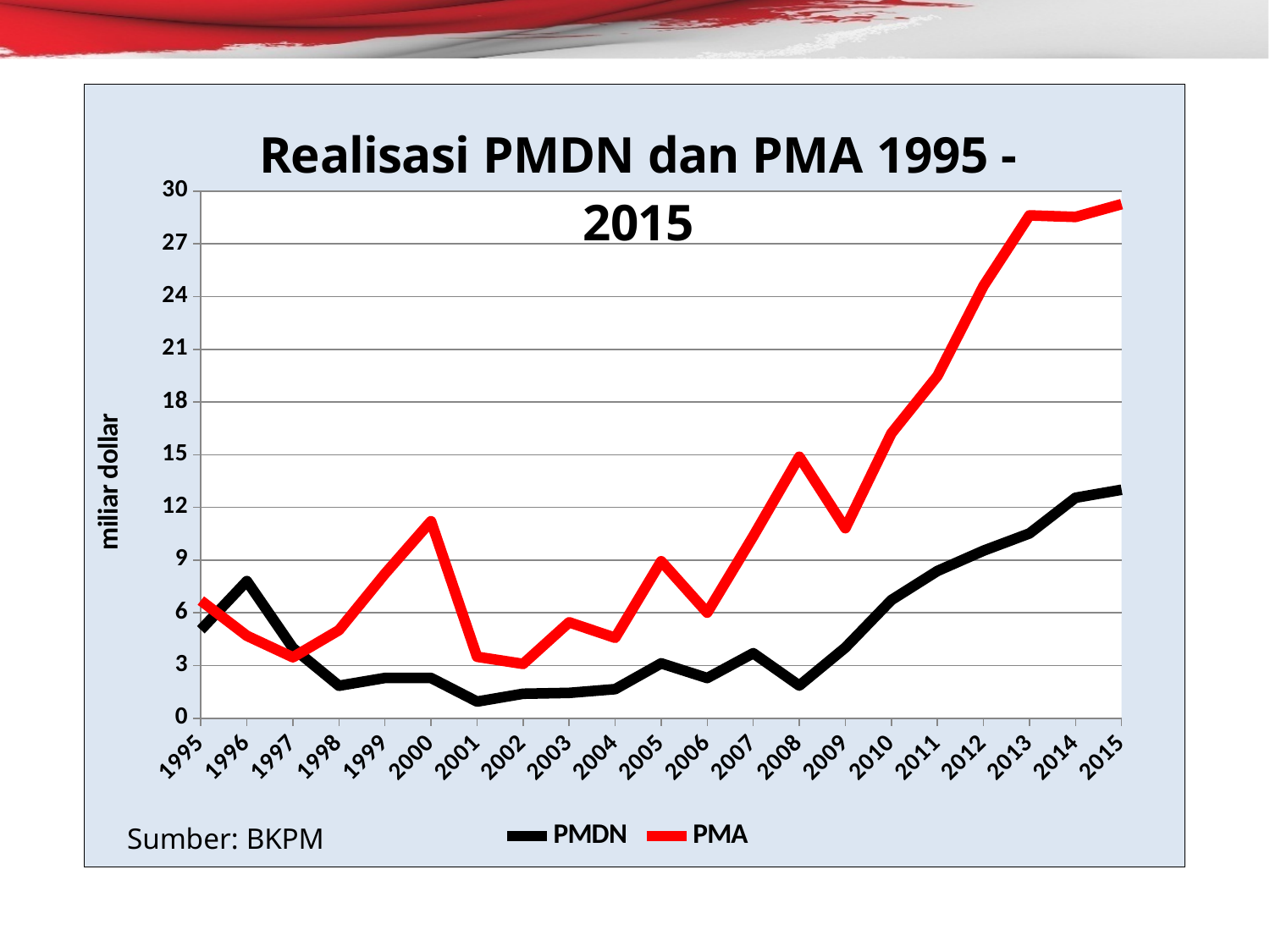
In which year does the PMA series reach its highest value? 2015 What is the label on the vertical axis? miliar dollar What kind of chart is shown on the slide? line chart In 1996, which series has the larger value, PMDN or PMA? PMDN How many years are plotted along the x axis? 21 What is the title of the chart? Realisasi PMDN dan PMA 1995 - 2015 Is the PMA value for 2015 greater or less than 27? greater Is the PMDN value for 2015 greater or less than 12? greater In 2015, which series has the larger value, PMDN or PMA? PMA How many series does the legend list? 2 Is the PMA value for 2000 greater or less than 9? greater